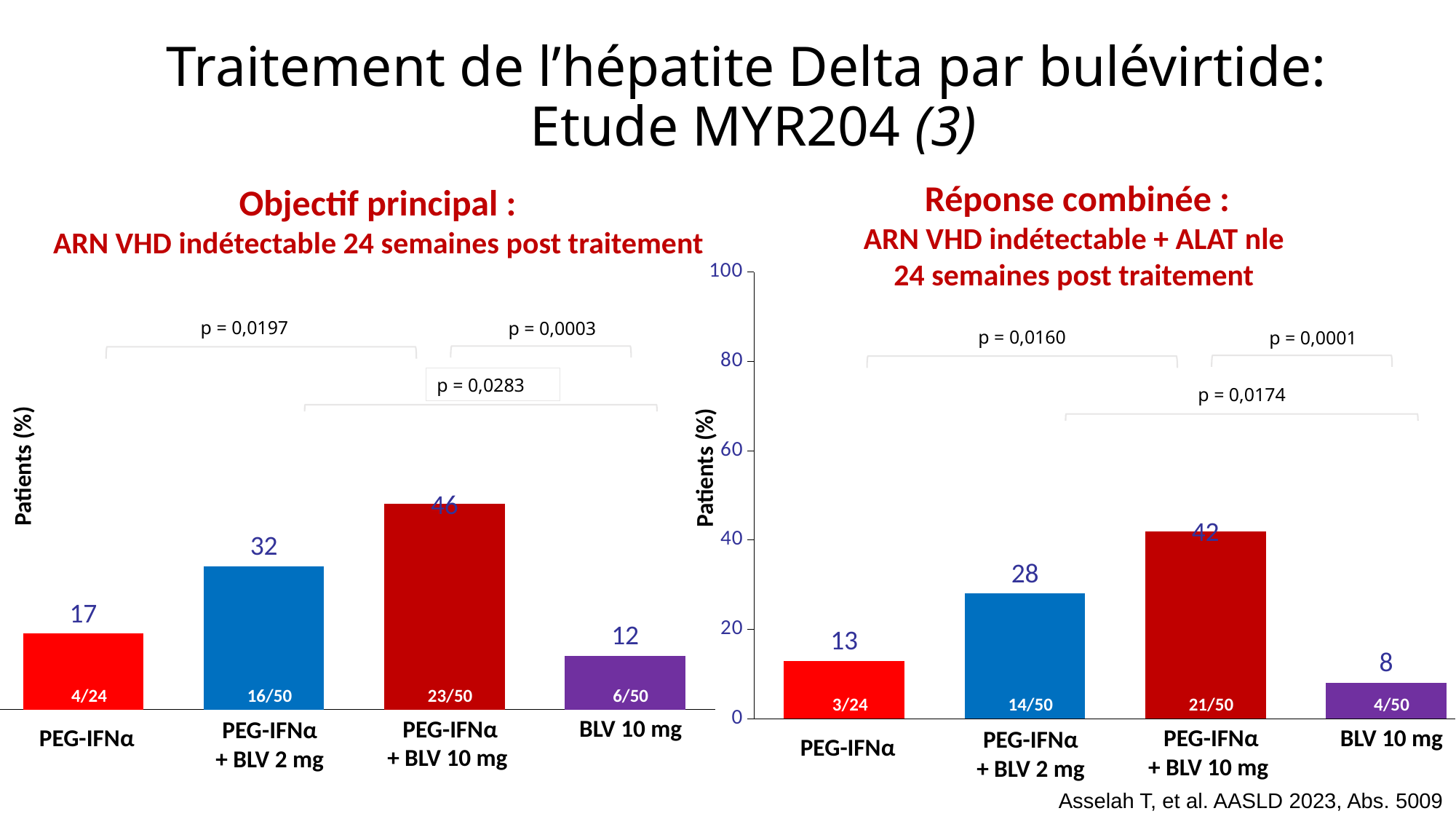
In the right chart (Réponse combinée), what is the value for BLV 10 mg? 8 In the right chart (Réponse combinée), which is larger: PEG-IFNα or BLV 10 mg? PEG-IFNα What is the y-axis label of the right chart (Réponse combinée)? Patients (%) In the right chart (Réponse combinée), which category has the highest value? PEG-IFNα + BLV 10 mg In the left chart (Objectif principal), what is the value for PEG-IFNα + BLV 10 mg? 46 In the left chart (Objectif principal), which category has the lowest value? BLV 10 mg How many categories are shown in the right chart (Réponse combinée)? 4 In the left chart (Objectif principal), is the value for PEG-IFNα + BLV 2 mg greater or less than 20? greater What kind of chart is the left chart (Objectif principal)? bar chart In the left chart (Objectif principal), what is the difference between PEG-IFNα + BLV 10 mg and PEG-IFNα + BLV 2 mg? 14 In the left chart (Objectif principal), what fraction is printed inside the PEG-IFNα + BLV 10 mg bar? 23/50 In the right chart (Réponse combinée), what is the difference between PEG-IFNα + BLV 2 mg and PEG-IFNα? 15